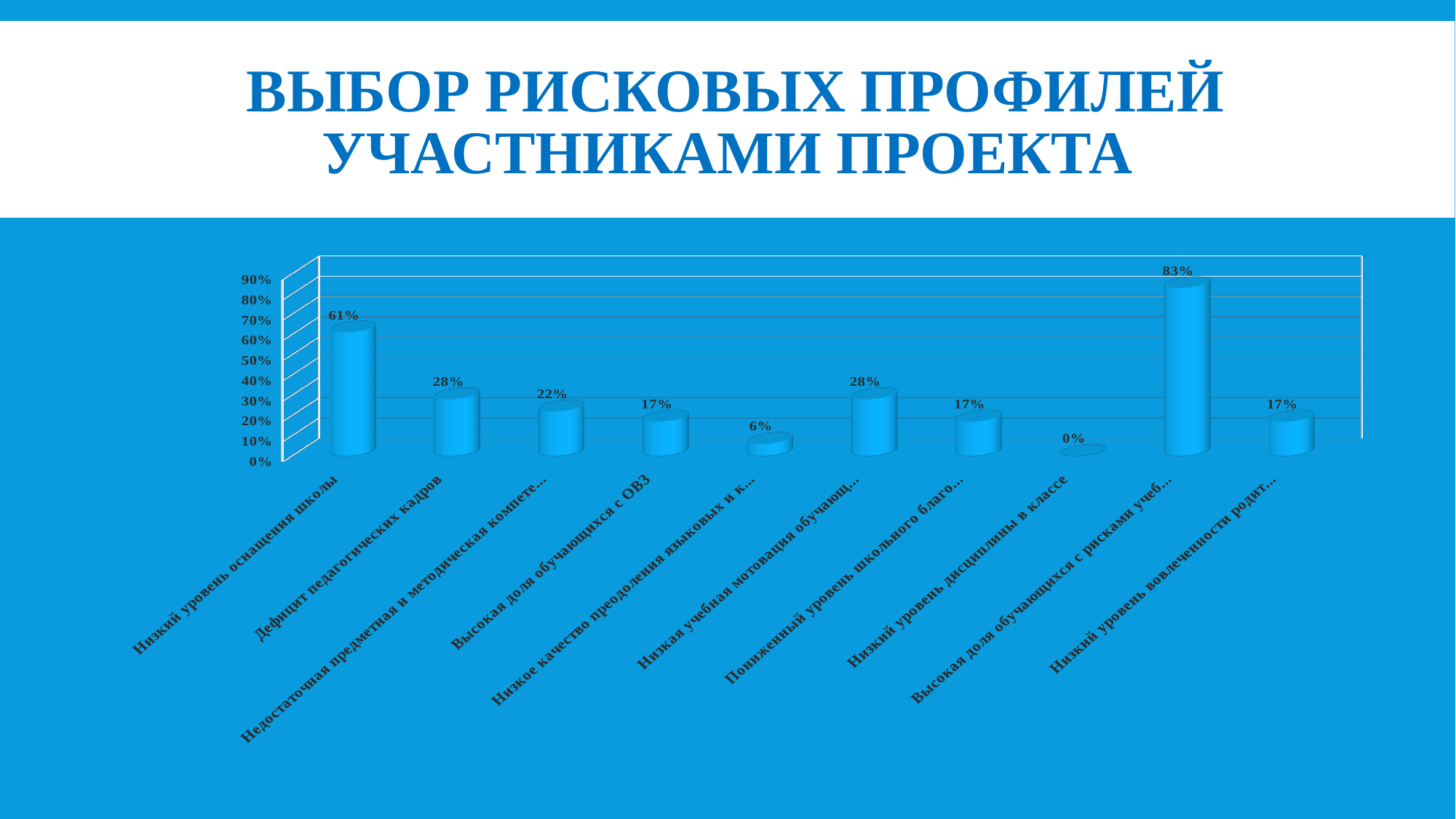
Is the value for "Дефицит педагогических кадров" greater or less than 50%? less What value is shown for "Низкий уровень оснащения школы"? 61% What value is shown for "Низкий уровень дисциплины в классе"? 0% What is the title of the slide? ВЫБОР РИСКОВЫХ ПРОФИЛЕЙ УЧАСТНИКАМИ ПРОЕКТА Which category has the highest value on the chart? Высокая доля обучающихся с рисками учеб... How many categories are shown on the chart? 10 What kind of chart is shown on the slide? bar chart What value is shown for "Высокая доля обучающихся с ОВЗ"? 17% What is the difference between the value for "Низкий уровень оснащения школы" and the value for "Дефицит педагогических кадров"? 33% Which is larger: the value for "Низкий уровень оснащения школы" or the value for "Высокая доля обучающихся с ОВЗ"? Низкий уровень оснащения школы What value is shown for "Дефицит педагогических кадров"? 28% Which category has the lowest value on the chart? Низкий уровень дисциплины в классе